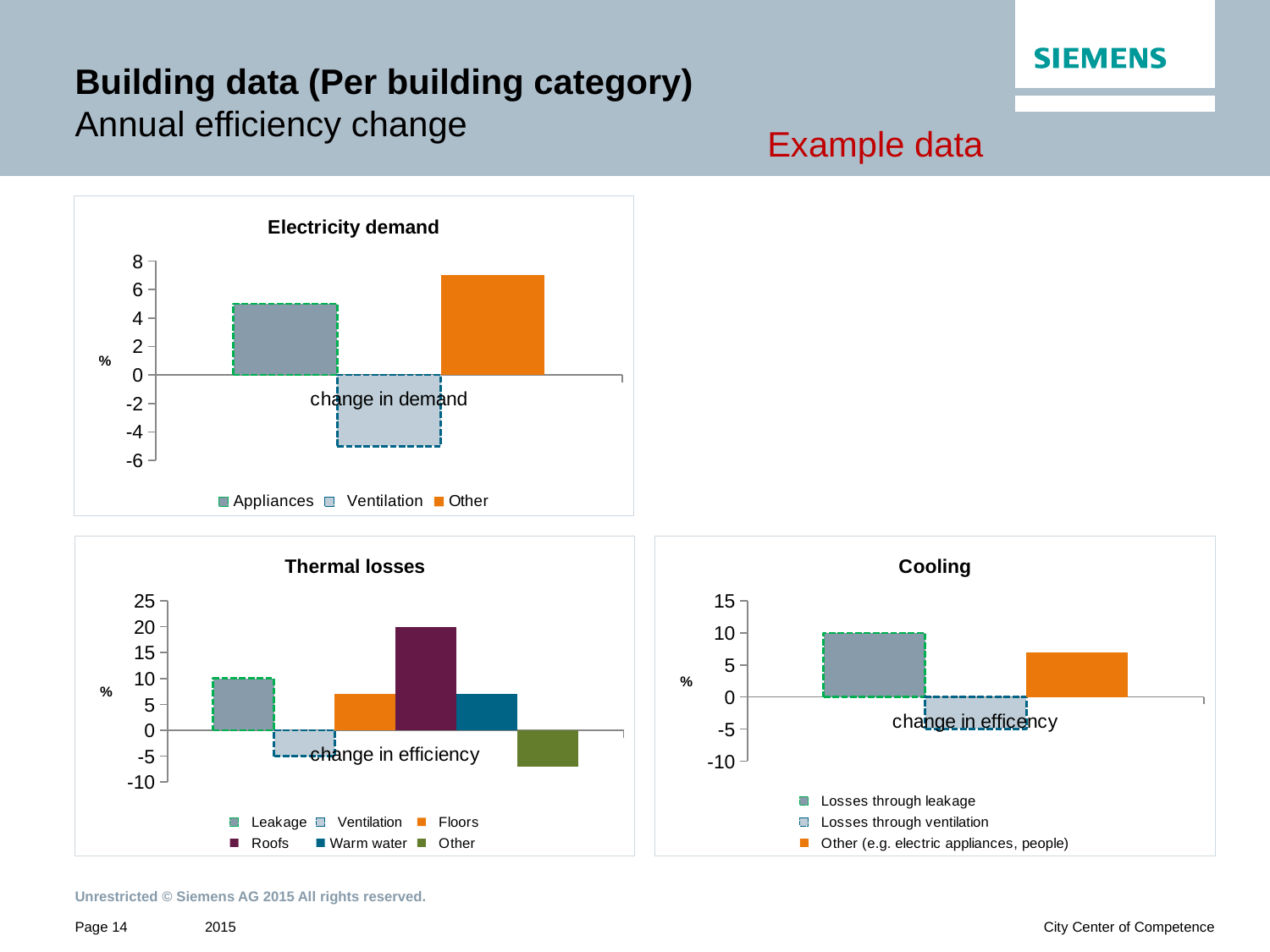
In the 'Thermal losses' chart, which series has the highest value? Roofs In the 'Cooling' chart, is the value for Losses through ventilation greater or less than 0? less In the 'Cooling' chart, which is larger, the value for Losses through leakage or the value for Other (e.g. electric appliances, people)? Losses through leakage In the 'Electricity demand' chart, which series has the lowest value? Ventilation What kind of chart is the 'Electricity demand' chart? bar chart In the 'Thermal losses' chart, how many series does the legend list? 6 In the 'Electricity demand' chart, which series has the highest value? Other What is the title of the chart at the bottom right of the slide? Cooling In the 'Electricity demand' chart, is the value for Other greater or less than 6? greater In the 'Thermal losses' chart, is the value for Roofs greater or less than 15? greater In the 'Thermal losses' chart, which series has the lowest value? Other In the 'Electricity demand' chart, how many series does the legend list? 3